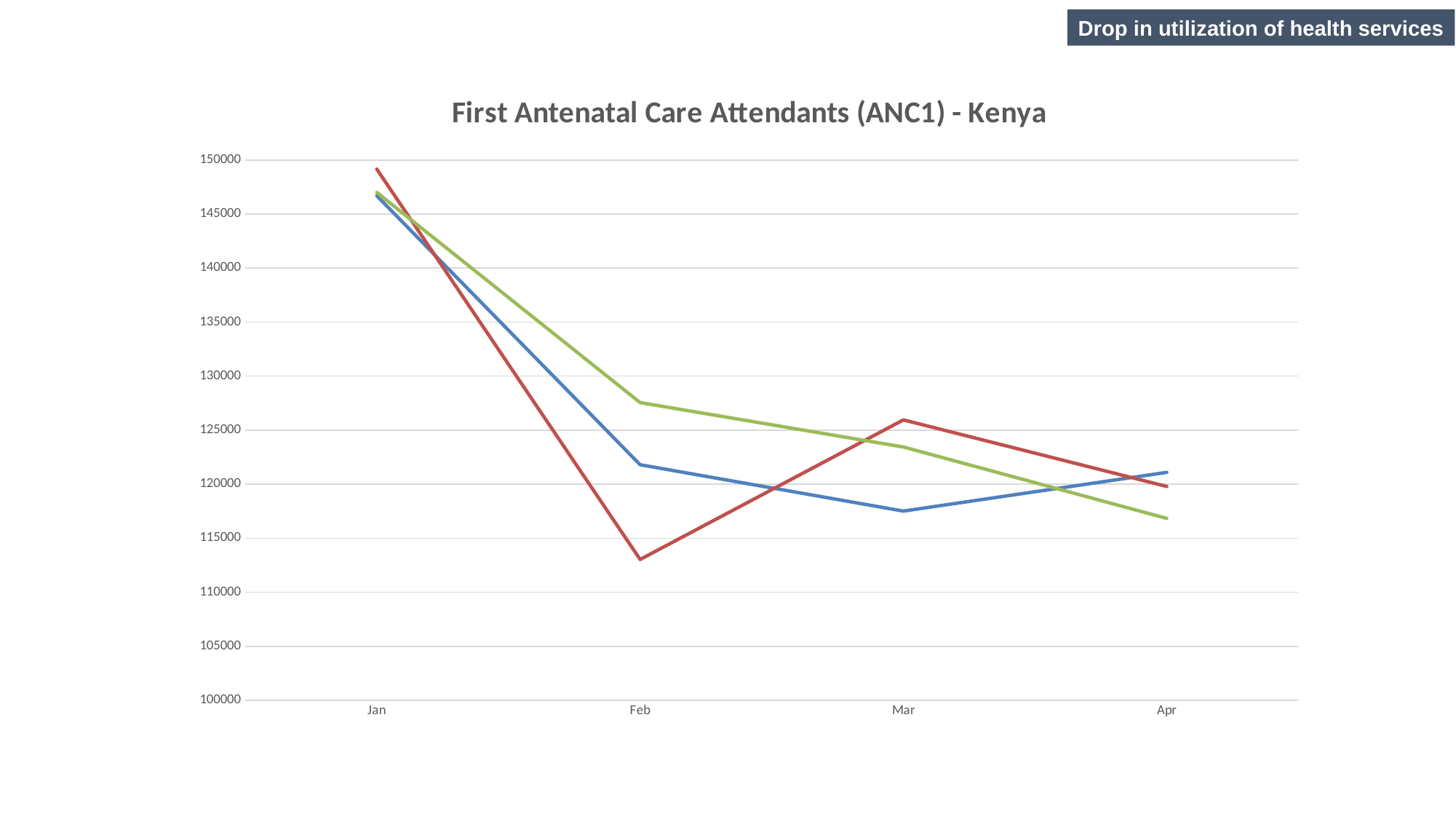
Does the red line rise or fall from Feb to Mar? rise Is the value of the green line in Apr greater or less than 120000? less What kind of chart is shown on the slide? line chart Is the value of the green line in Feb greater or less than 125000? greater How many months are shown on the x axis of the chart? 4 In Mar, which line has the higher value, the red line or the blue line? red line Is the value of the blue line in Mar greater or less than 120000? less In Feb, which line has the higher value, the green line or the red line? green line What is the title of the chart? First Antenatal Care Attendants (ANC1) - Kenya How many lines are plotted on the chart? 3 Does the green line rise or fall from Jan to Apr? fall